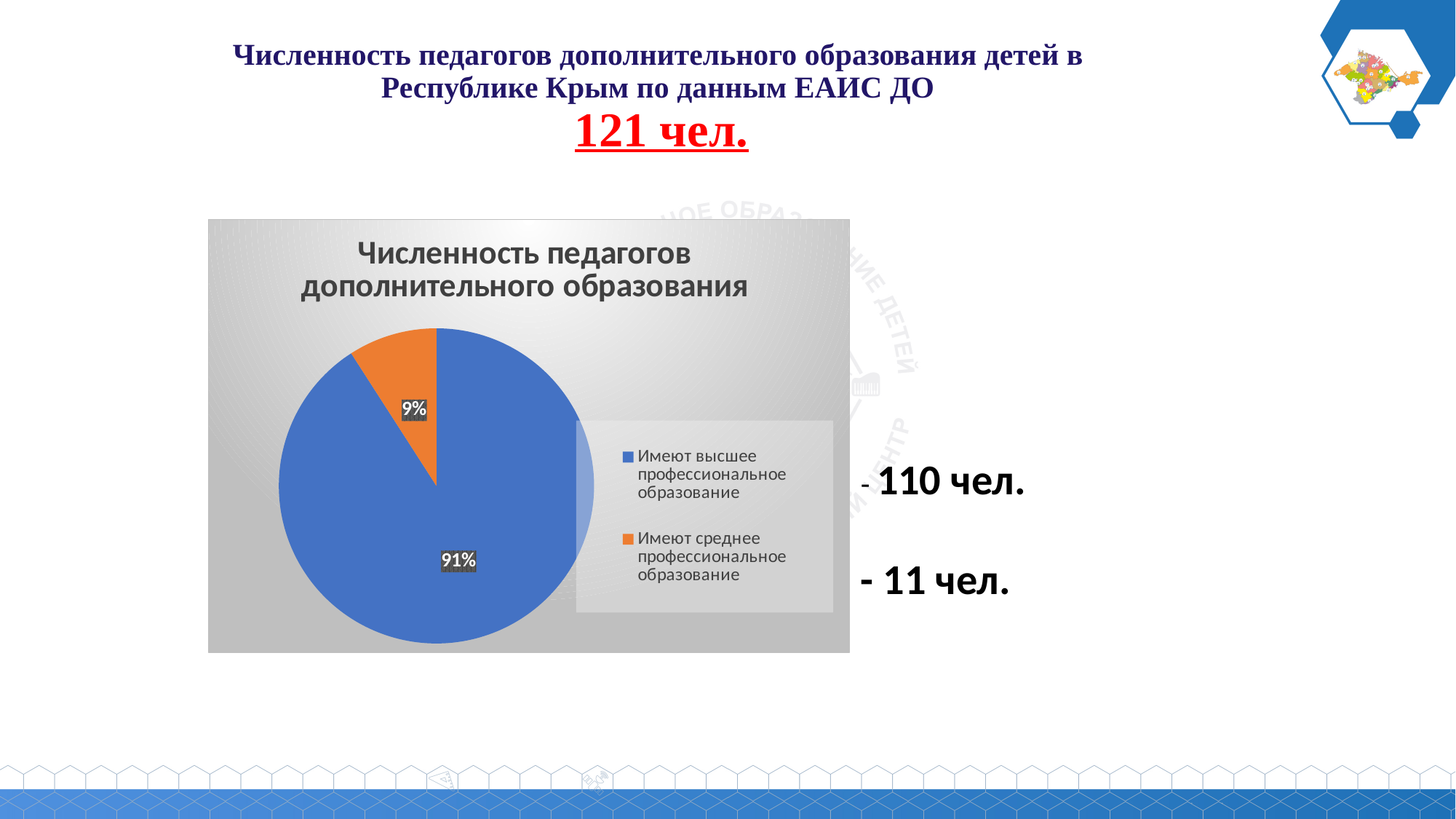
What share of the pie is labelled for "Имеют высшее профессиональное образование"? 91% What is the title of the pie chart? Численность педагогов дополнительного образования Which slice is larger: "Имеют высшее профессиональное образование" or "Имеют среднее профессиональное образование"? Имеют высшее профессиональное образование How many slices does the pie chart have? 2 What kind of chart is shown on the slide? pie chart How many entries does the legend list? 2 What share of the pie is labelled for "Имеют среднее профессиональное образование"? 9% What colour is the slice for "Имеют среднее профессиональное образование"? orange What is the difference in percentage points between the two slices of the pie? 82 Which category has the smallest slice of the pie? Имеют среднее профессиональное образование What is the total number of teachers shown in red under the slide title? 121 чел. Which category has the largest slice of the pie? Имеют высшее профессиональное образование